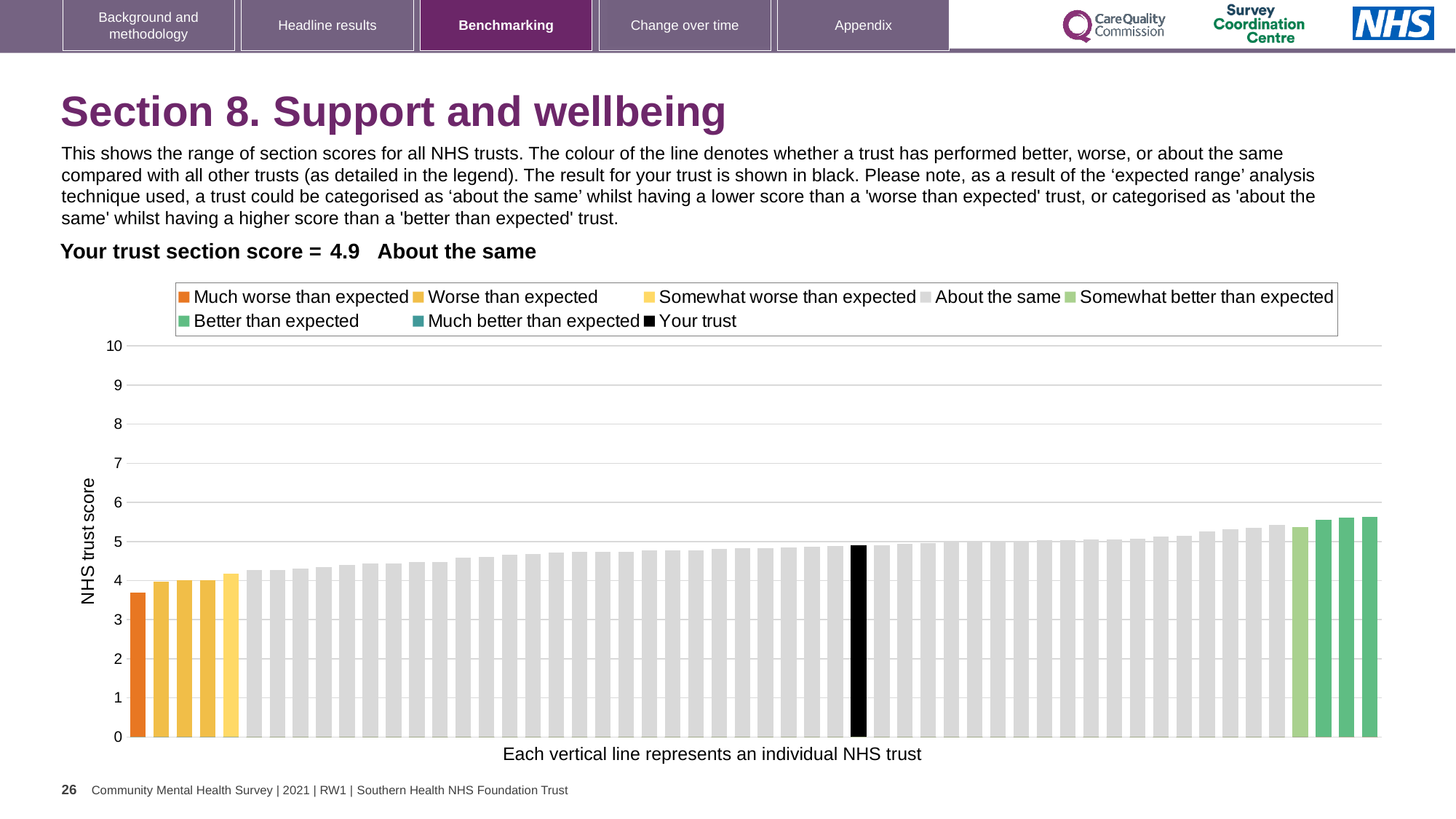
Is the value for your trust (black bar) greater or less than 4? greater Is the value for the lowest (orange) bar greater or less than 4? less What is the section score for your trust shown on the slide? 4.9 Which category is your trust placed in for this section? About the same Is the value for the highest bar on the right greater or less than 6? less What kind of chart is shown on the slide? bar chart How many bars are coloured orange (Much worse than expected)? 1 How many entries does the chart legend list? 8 How many bars are coloured dark green (Better than expected)? 3 Do the bar values rise or fall from left to right along the x axis? rise What colour is the bar representing your trust? black